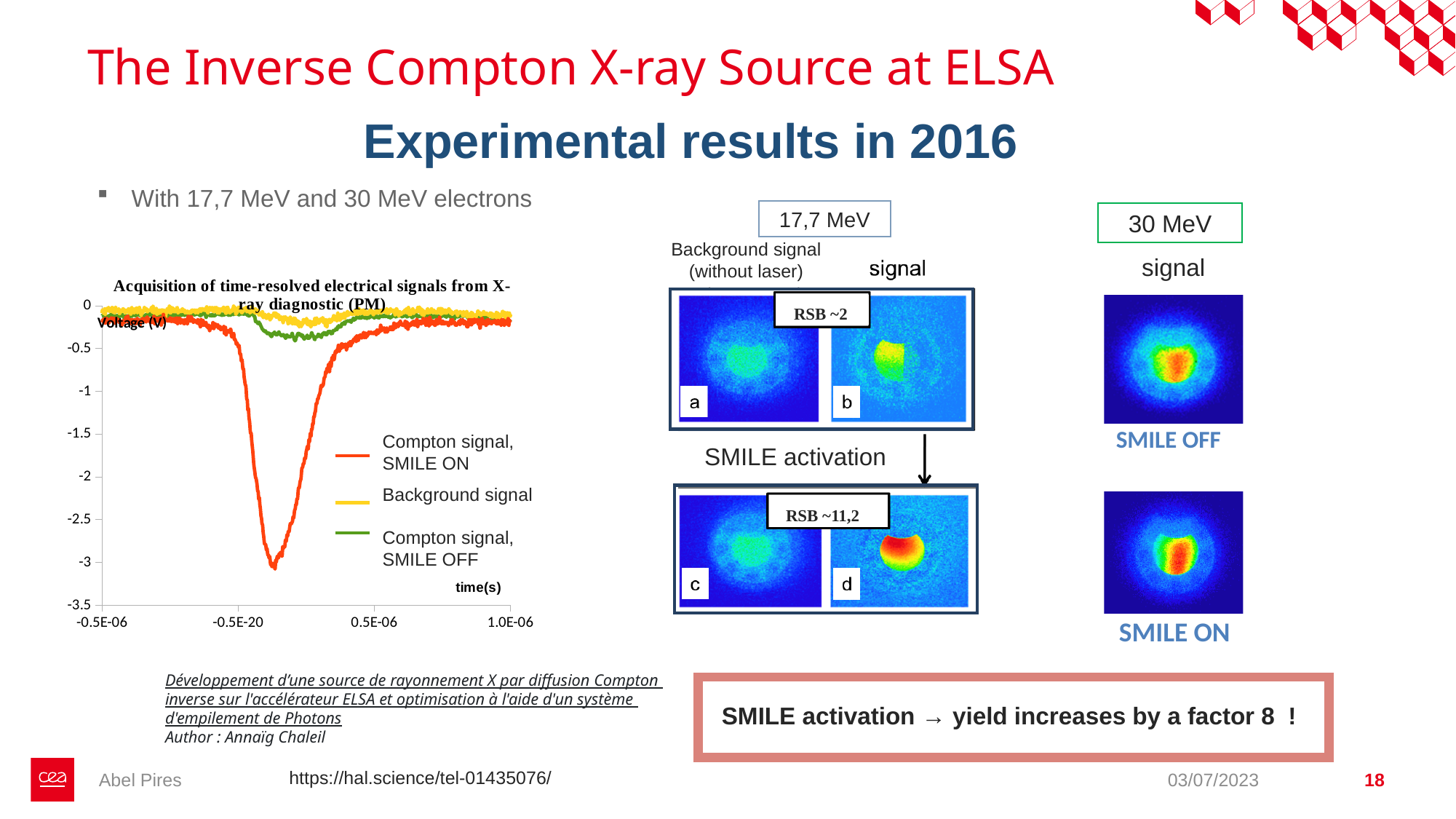
What kind of chart is shown on the slide? line chart Which series dips deeper: Compton signal, SMILE ON or Compton signal, SMILE OFF? Compton signal, SMILE ON Is the minimum voltage of the Compton signal, SMILE ON series greater or less than -2.5? less What quantity is plotted on the vertical axis of the chart? Voltage (V) What is the title of the chart? Acquisition of time-resolved electrical signals from X-ray diagnostic (PM) What is the lowest value shown on the vertical axis of the chart? -3.5 Which series stays closest to 0 V across the whole time range? Background signal How many series does the chart legend list? 3 Which series reaches the lowest voltage in the chart? Compton signal, SMILE ON Is the Background signal series greater or less than -0.5 V throughout the chart? greater Is the minimum voltage of the Compton signal, SMILE OFF series greater or less than -1? greater